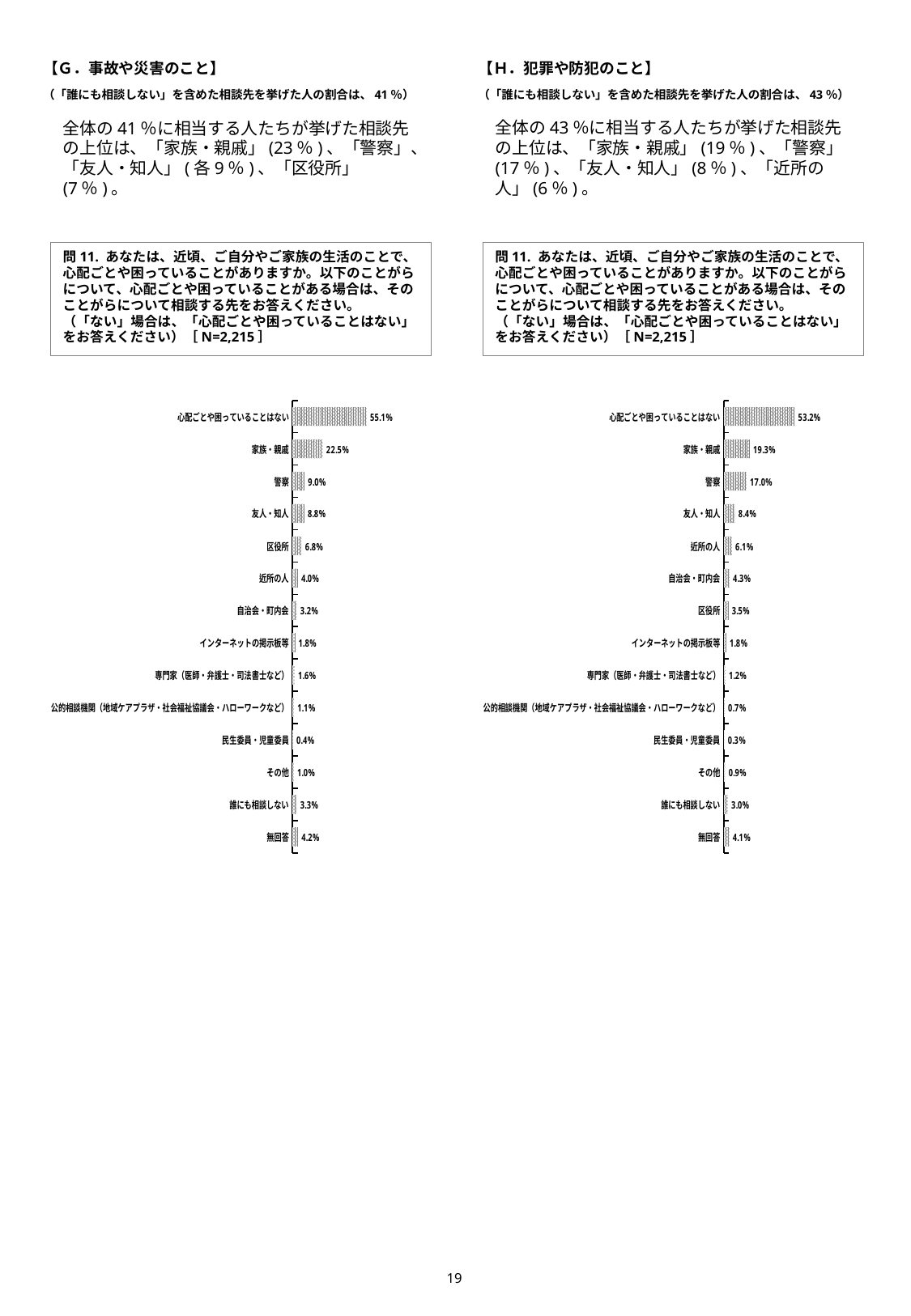
In the left chart (G. 事故や災害のこと), what is the value for 誰にも相談しない? 3.3% In the right chart (H. 犯罪や防犯のこと), which category has the lowest value? 民生委員・児童委員 In the right chart (H. 犯罪や防犯のこと), which is larger: the value for 無回答 or the value for 誰にも相談しない? 無回答 In the right chart (H. 犯罪や防犯のこと), what is the difference between the values for 家族・親戚 and 警察? 2.3% In the left chart (G. 事故や災害のこと), what is the difference between the values for 警察 and 区役所? 2.2% In the left chart (G. 事故や災害のこと), what is the value for 家族・親戚? 22.5% In the right chart (H. 犯罪や防犯のこと), what is the value for 心配ごとや困っていることはない? 53.2% In the left chart (G. 事故や災害のこと), which is larger: the value for 近所の人 or the value for 自治会・町内会? 近所の人 In the left chart (G. 事故や災害のこと), which category has the highest value? 心配ごとや困っていることはない In the right chart (H. 犯罪や防犯のこと), what is the value for 警察? 17.0% What kind of chart is the right chart (H. 犯罪や防犯のこと)? Bar chart How many categories are shown in the left chart (G. 事故や災害のこと)? 14